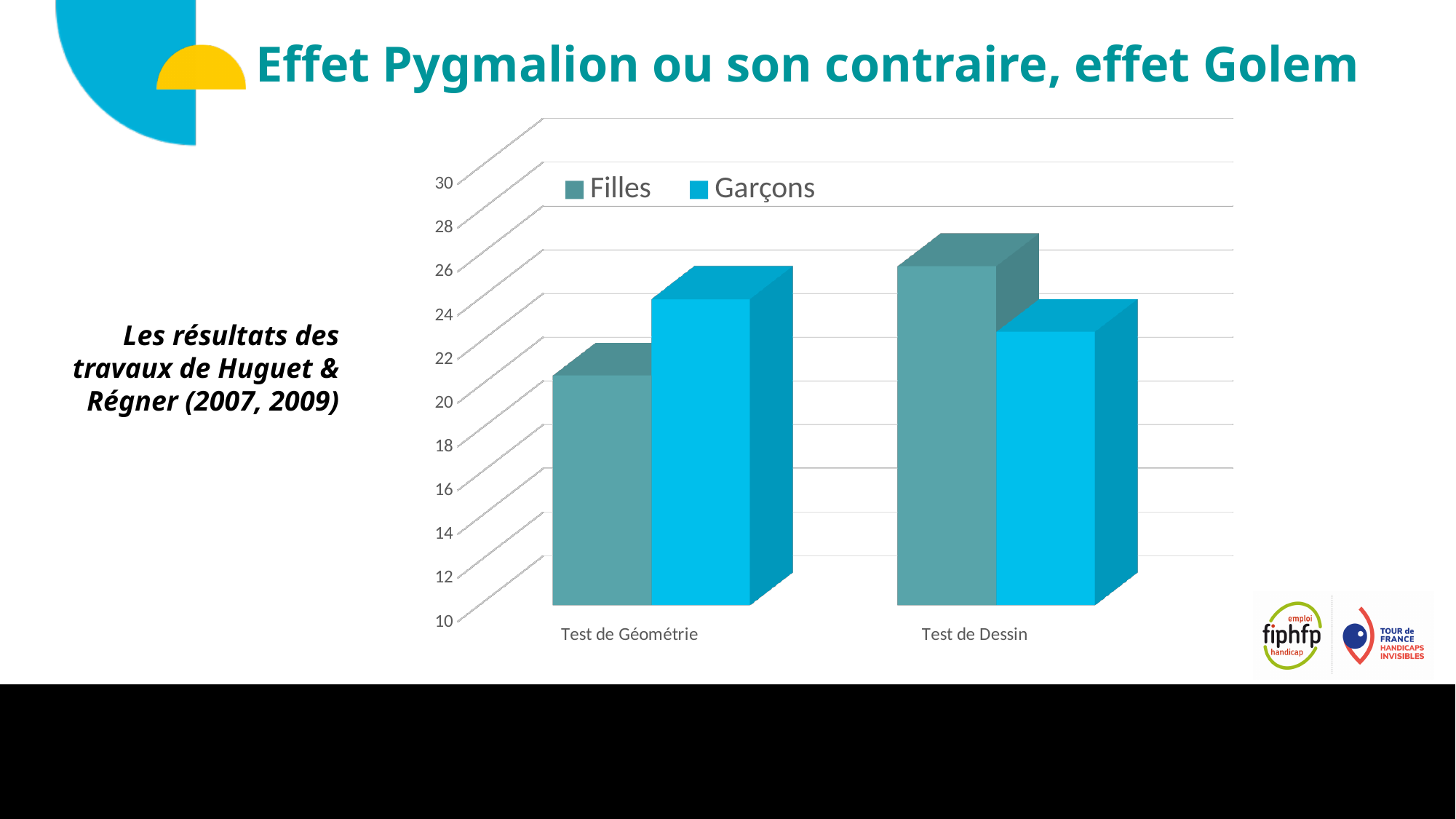
Which bar is the lowest in the chart? Filles, Test de Géométrie Is the value for Garçons in Test de Géométrie greater or less than 22? greater Is the value for Garçons in Test de Dessin greater or less than 26? less What are the two categories on the x axis of the chart? Test de Géométrie and Test de Dessin What kind of chart is shown on the slide? bar chart How many categories are shown on the x axis of the chart? 2 Which series are listed in the chart legend? Filles and Garçons Is the value for Filles in Test de Géométrie greater or less than 24? less For Test de Géométrie, which series has the higher bar, Filles or Garçons? Garçons For Test de Dessin, which series has the higher bar, Filles or Garçons? Filles How many series does the chart legend list? 2 Which bar is the highest in the chart? Filles, Test de Dessin